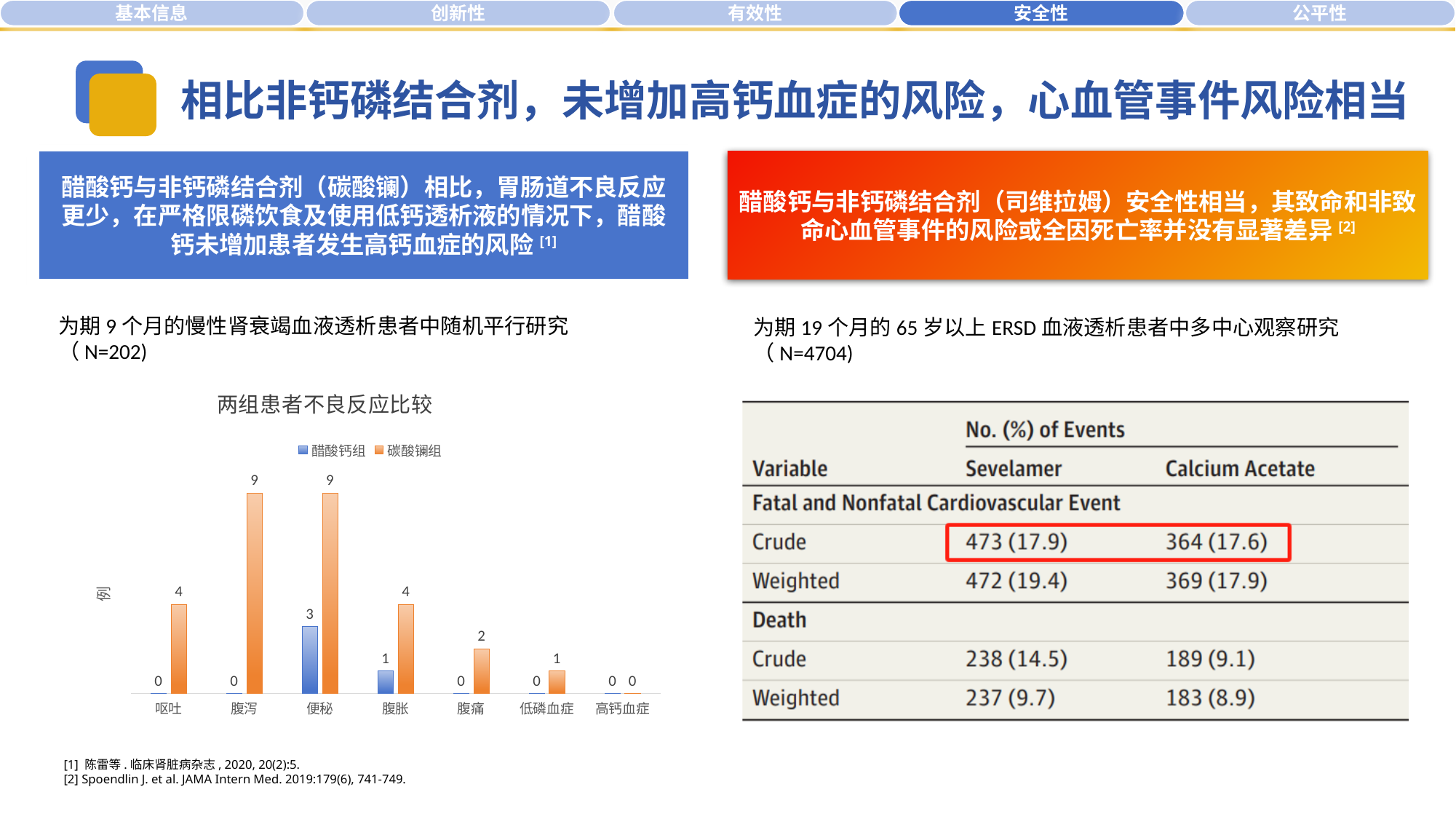
What is the value for 醋酸钙组 in the 便秘 category? 3 What is the value for 碳酸镧组 in the 腹泻 category? 9 What type of chart is shown under the title 两组患者不良反应比较? bar chart What is the difference between the 碳酸镧组 values for 腹泻 and 腹痛? 7 Which is larger in the 腹胀 category, 醋酸钙组 or 碳酸镧组? 碳酸镧组 What is the value for 碳酸镧组 in the 腹胀 category? 4 Which category has the highest value for 醋酸钙组? 便秘 What is the title of the bar chart on the slide? 两组患者不良反应比较 What is the difference between 碳酸镧组 and 醋酸钙组 in the 便秘 category? 6 What is the value for 醋酸钙组 in the 高钙血症 category? 0 How many series does the legend of the chart list? 2 How many categories are shown on the x axis of the chart? 7